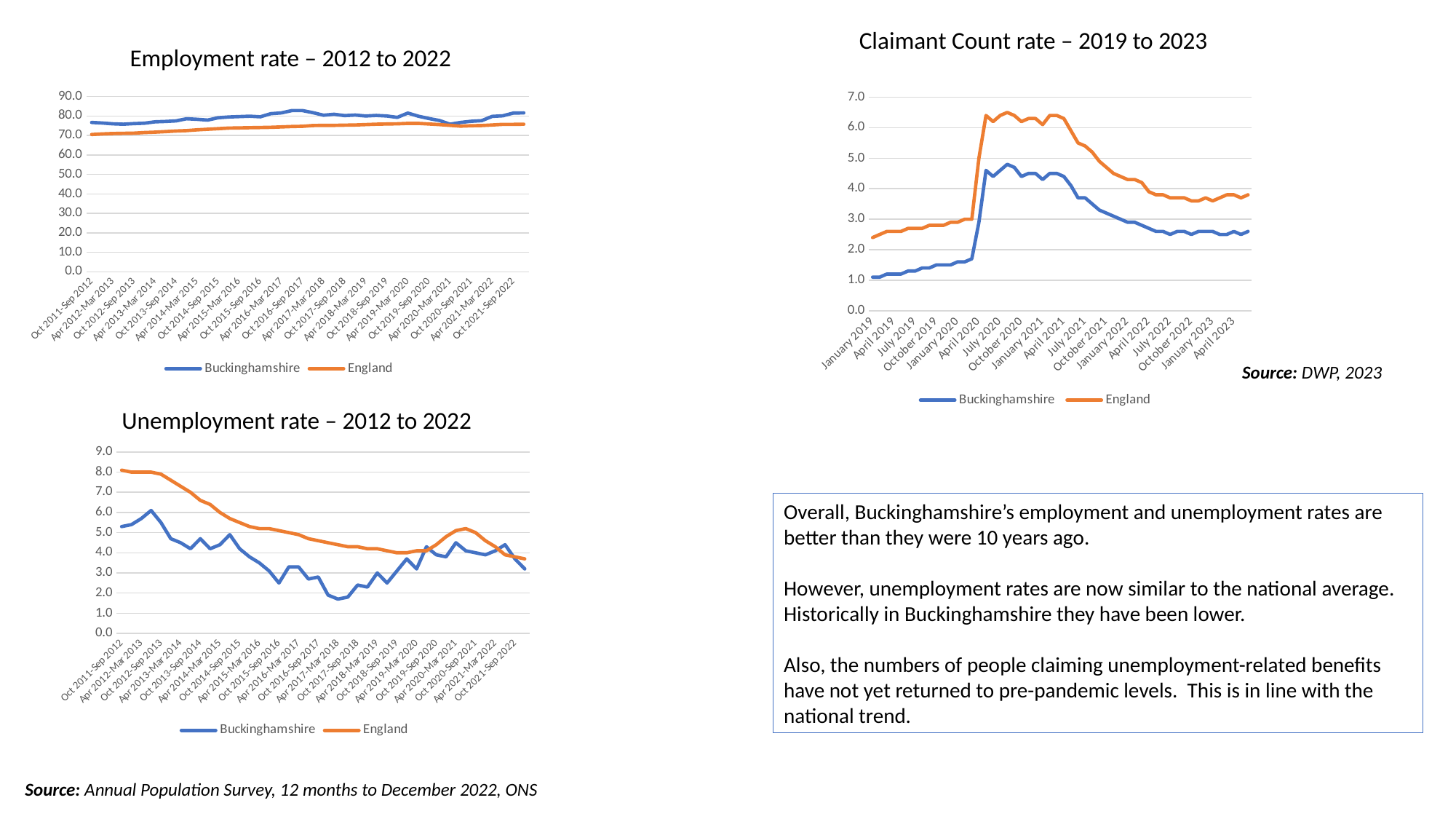
In the 'Employment rate – 2012 to 2022' chart, is the value for Buckinghamshire at Oct 2016-Sep 2017 greater or less than 80.0? greater What kind of chart is the 'Employment rate – 2012 to 2022' chart? line chart In the 'Employment rate – 2012 to 2022' chart, which series is higher at Oct 2016-Sep 2017, Buckinghamshire or England? Buckinghamshire In the 'Claimant Count rate – 2019 to 2023' chart, is the value for England at July 2020 greater or less than 6.0? greater What source is cited for the 'Claimant Count rate – 2019 to 2023' chart? DWP, 2023 In the 'Unemployment rate – 2012 to 2022' chart, does the England line rise or fall overall from Oct 2011-Sep 2012 to Oct 2021-Sep 2022? fall In the 'Unemployment rate – 2012 to 2022' chart, is the value for England at Oct 2011-Sep 2012 greater or less than 7.0? greater In the 'Unemployment rate – 2012 to 2022' chart, which series is higher at Apr 2012-Mar 2013, Buckinghamshire or England? England In the 'Claimant Count rate – 2019 to 2023' chart, which series is higher at October 2020, Buckinghamshire or England? England How many series does the legend of the 'Claimant Count rate – 2019 to 2023' chart list? 2 In the 'Employment rate – 2012 to 2022' chart, does the England line rise or fall from Oct 2011-Sep 2012 to Oct 2021-Sep 2022? rise